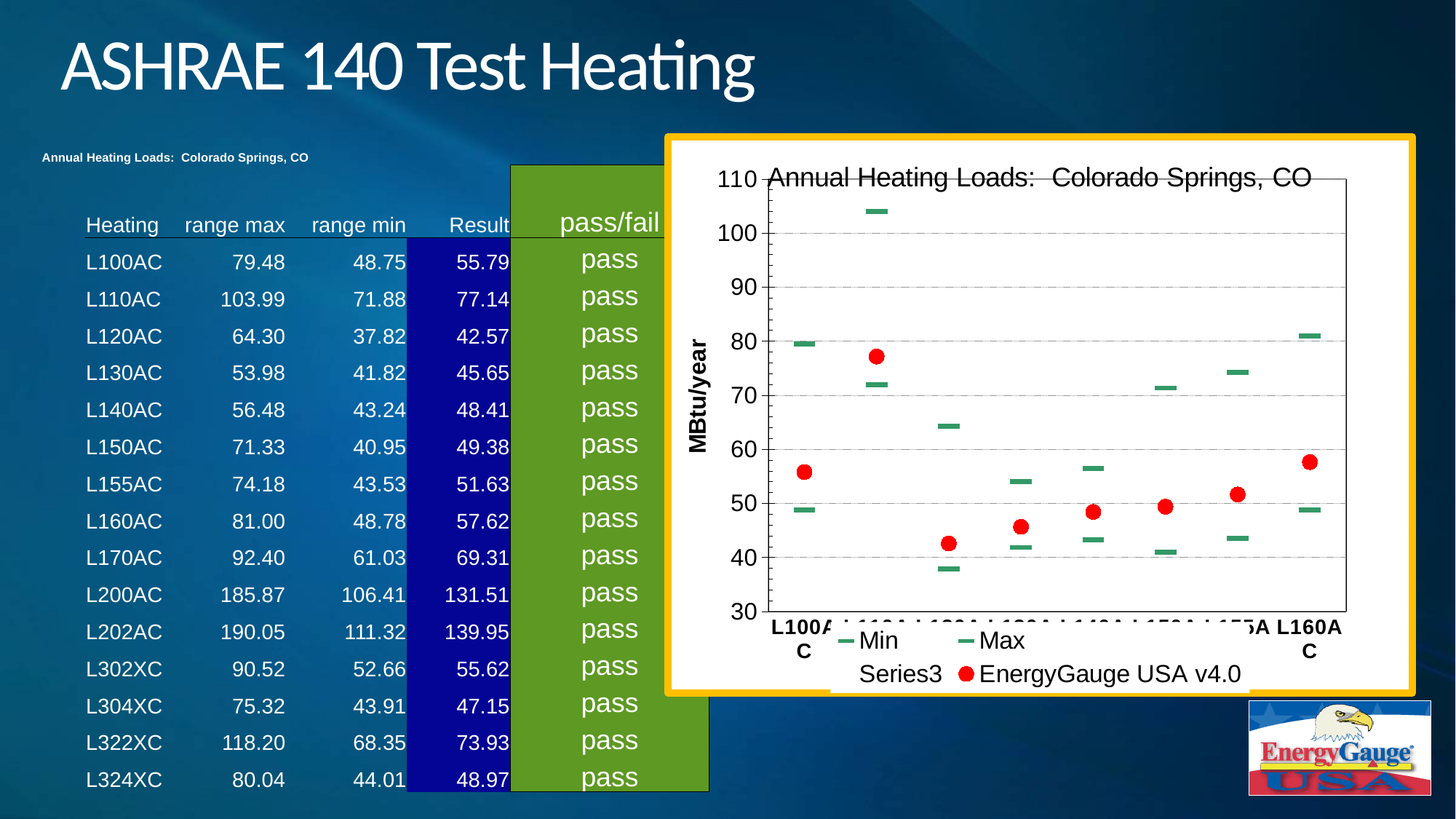
In the chart, is the EnergyGauge USA v4.0 value for L160AC greater or less than 50? greater What is the title of the chart on the slide? Annual Heating Loads: Colorado Springs, CO In the chart, is the EnergyGauge USA v4.0 value for L160AC greater or less than 60? less In the chart, is the EnergyGauge USA v4.0 value for L100AC greater or less than 70? less How many categories are plotted along the x axis of the chart? 8 How many series does the chart's legend list? 4 What is the label on the chart's vertical axis? MBtu/year